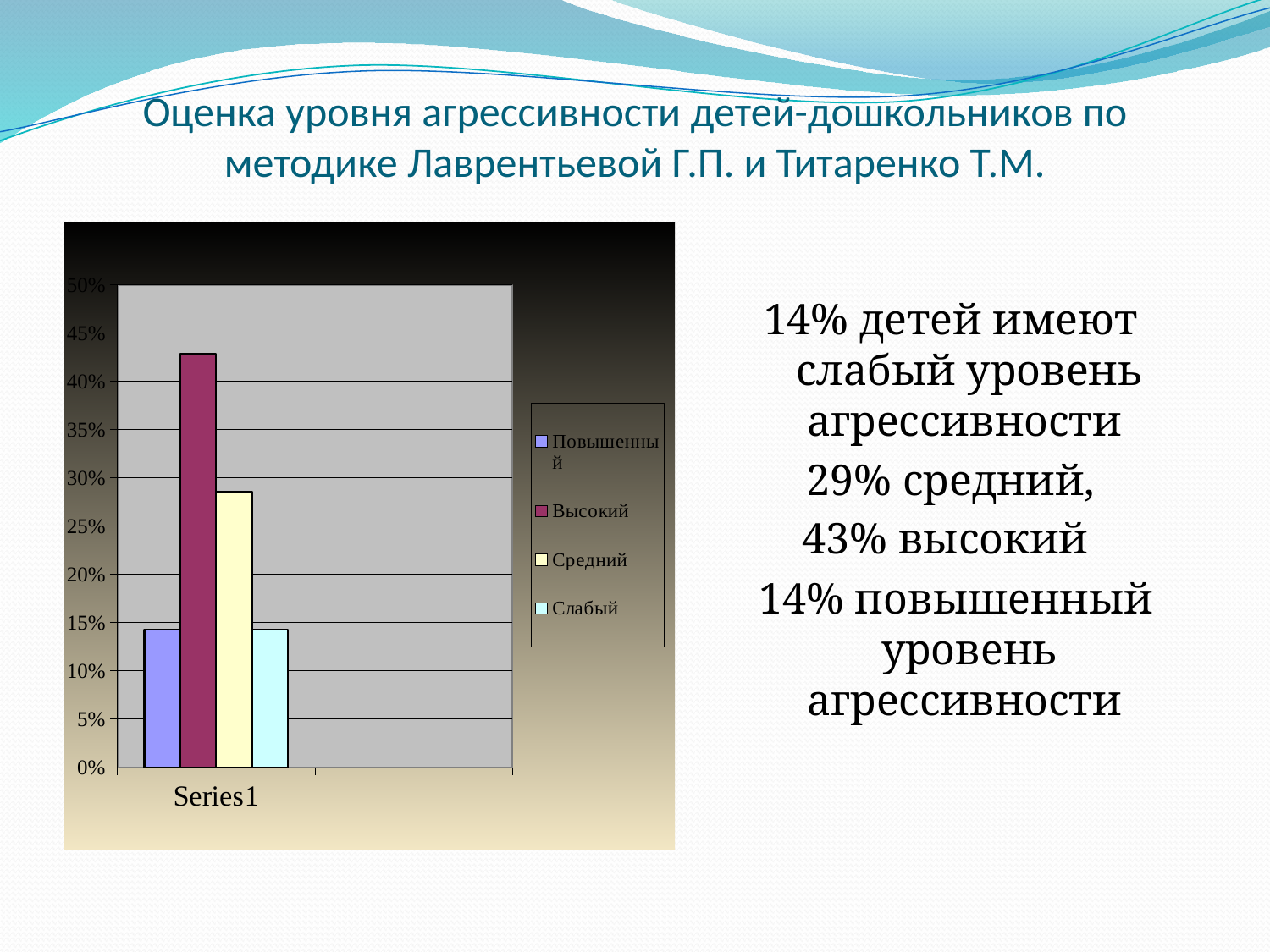
Is the bar for Высокий greater or less than 40%? greater Is the bar for Повышенный greater or less than 10%? greater According to the slide, what percentage of children have a high (высокий) level of aggressiveness? 43% Which bar is taller, Высокий or Средний? Высокий Which bar is taller, Средний or Слабый? Средний Which legend entry has the tallest bar in the chart? Высокий What is the label shown on the category axis of the chart? Series1 Is the bar for Средний greater or less than 30%? less What kind of chart is shown on the slide? bar chart How many bars are plotted in the chart? 4 How many entries does the chart legend list? 4